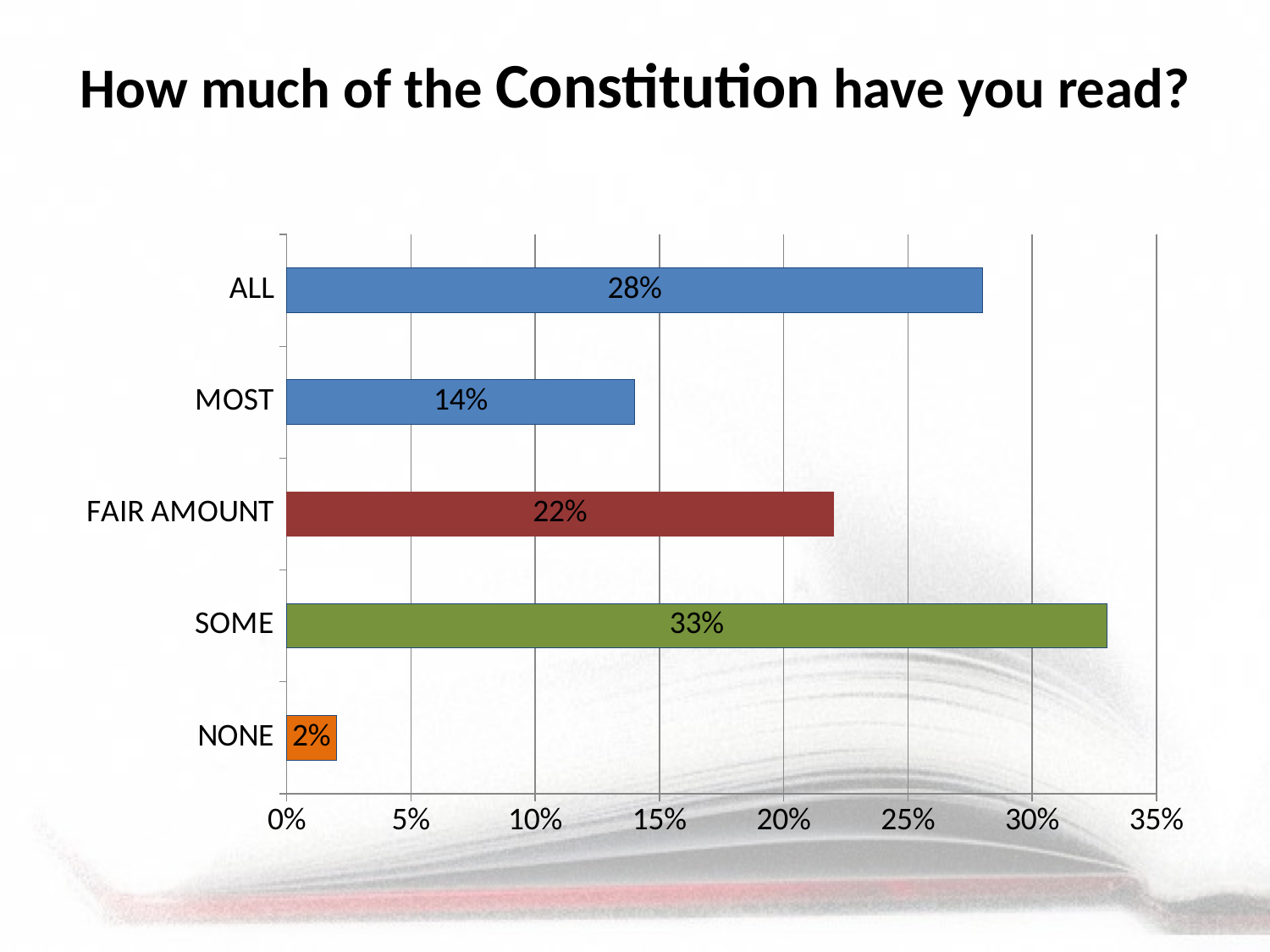
What is the value for NONE? 2% Which is larger, the value for ALL or the value for FAIR AMOUNT? ALL What is the difference between the values for FAIR AMOUNT and MOST? 8% What kind of chart is shown on the slide? Bar chart How many categories are shown in the chart? 5 What percentage of respondents said they have read ALL of the Constitution? 28% What is the difference between the values for SOME and ALL? 5% What is the title of the slide? How much of the Constitution have you read? Which category has the highest value? SOME What percentage is shown for FAIR AMOUNT? 22% What is the value shown for MOST? 14% Which category has the lowest value? NONE